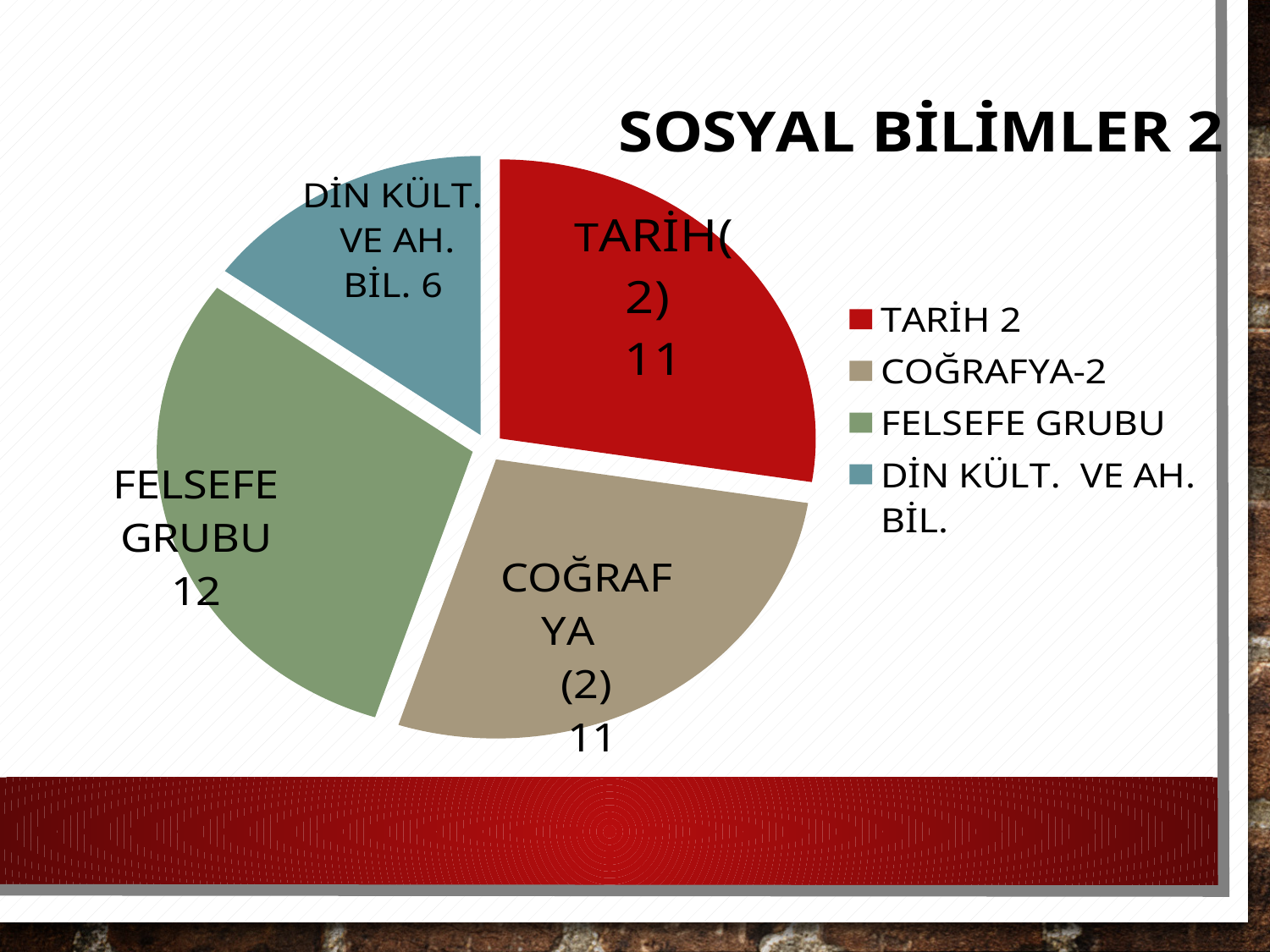
What type of chart is shown on the slide? Pie chart Which category has the smallest slice of the pie? DİN KÜLT. VE AH. BİL. What is the title of the chart? SOSYAL BİLİMLER 2 What is the value shown for TARİH 2? 11 What is the value shown for COĞRAFYA-2? 11 Which is larger, the value for FELSEFE GRUBU or the value for TARİH 2? FELSEFE GRUBU What is the difference between the values for FELSEFE GRUBU and DİN KÜLT. VE AH. BİL.? 6 What is the value shown for DİN KÜLT. VE AH. BİL.? 6 What is the value shown for FELSEFE GRUBU? 12 How many categories does the pie chart show? 4 What share of the pie does FELSEFE GRUBU represent? 30% Which category has the largest slice of the pie? FELSEFE GRUBU